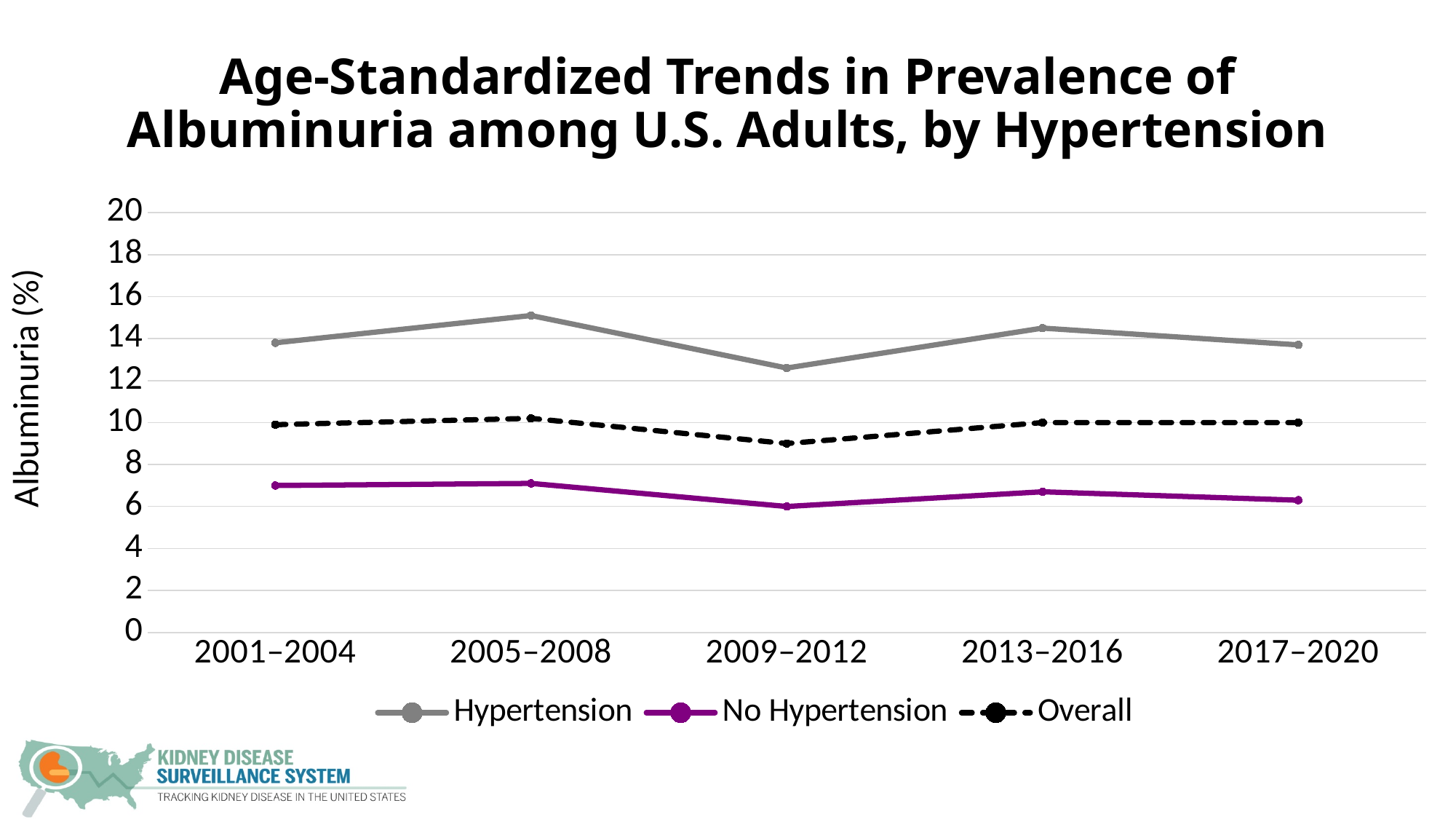
Which series is drawn with a dashed line? Overall What is the label of the y axis? Albuminuria (%) In which period is the Overall series lowest? 2009–2012 How many time periods are shown on the x axis? 5 Is the value for Hypertension in 2005–2008 greater or less than 14? greater Which is larger in 2017–2020, the Hypertension value or the No Hypertension value? Hypertension How many series does the legend list? 3 What kind of chart is shown on the slide? line chart Is the value for No Hypertension in 2009–2012 greater or less than 8? less In which period is the Hypertension series lowest? 2009–2012 Does the Hypertension series rise or fall from 2005–2008 to 2009–2012? fall In which period is the Hypertension series highest? 2005–2008